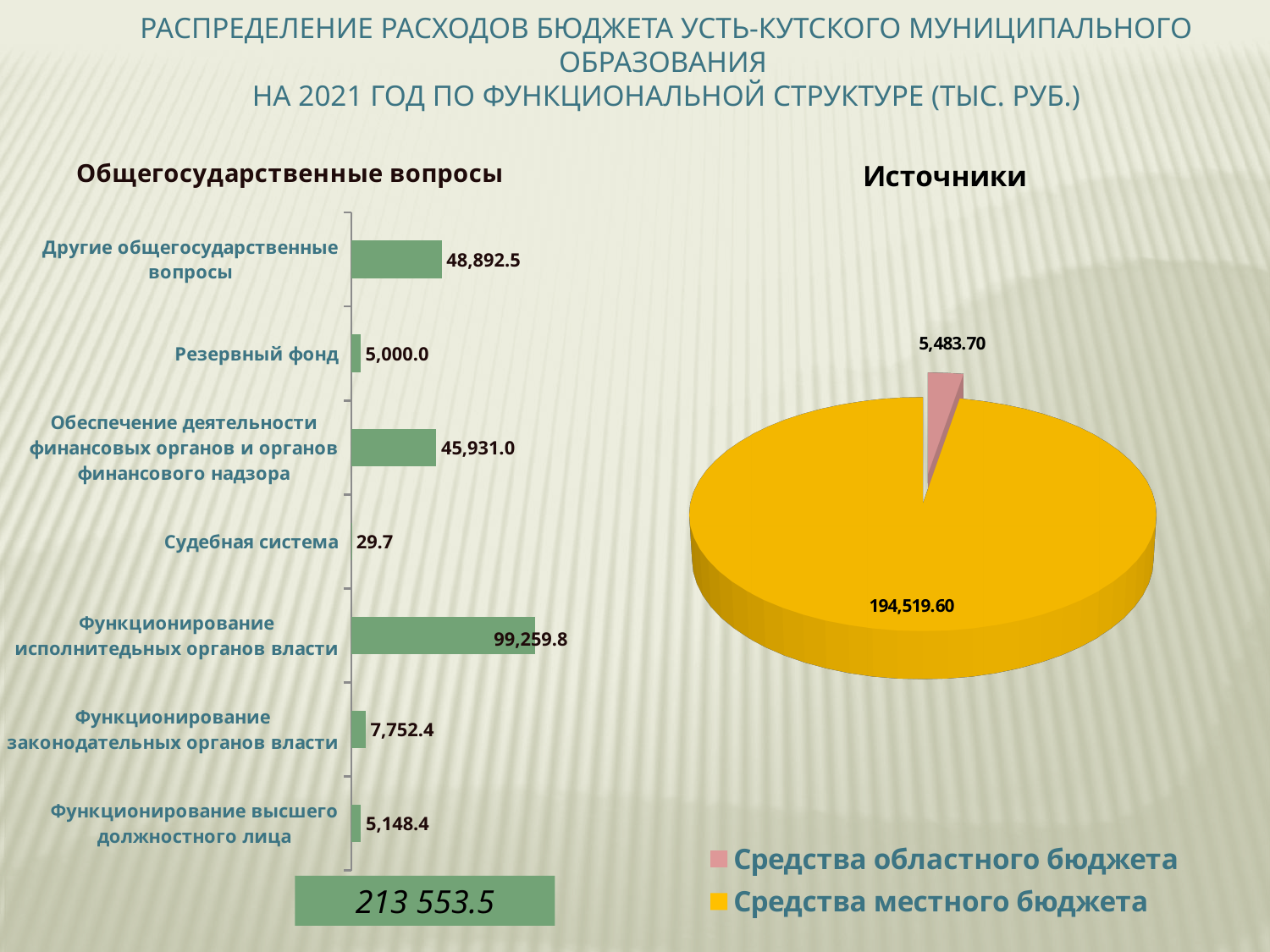
How many categories does the bar chart 'Общегосударственные вопросы' show? 7 In the pie chart 'Источники', what is the value for 'Средства областного бюджета'? 5,483.70 In the bar chart 'Общегосударственные вопросы', which is larger: 'Функционирование законодательных органов власти' or 'Функционирование высшего должностного лица'? Функционирование законодательных органов власти In the pie chart 'Источники', what is the difference between 'Средства местного бюджета' and 'Средства областного бюджета'? 189,035.90 In the pie chart 'Источники', what is the value for 'Средства местного бюджета'? 194,519.60 In the bar chart 'Общегосударственные вопросы', what is the value for 'Резервный фонд'? 5,000.0 How many series does the legend of the pie chart 'Источники' list? 2 In the bar chart 'Общегосударственные вопросы', which category has the lowest value? Судебная система What type of chart is the chart titled 'Общегосударственные вопросы'? Bar chart In the bar chart 'Общегосударственные вопросы', what is the value for 'Функционирование исполнительных органов власти'? 99,259.8 In the bar chart 'Общегосударственные вопросы', which category has the highest value? Функционирование исполнительных органов власти In the bar chart 'Общегосударственные вопросы', what is the difference between 'Функционирование исполнительных органов власти' and 'Другие общегосударственные вопросы'? 50,367.3